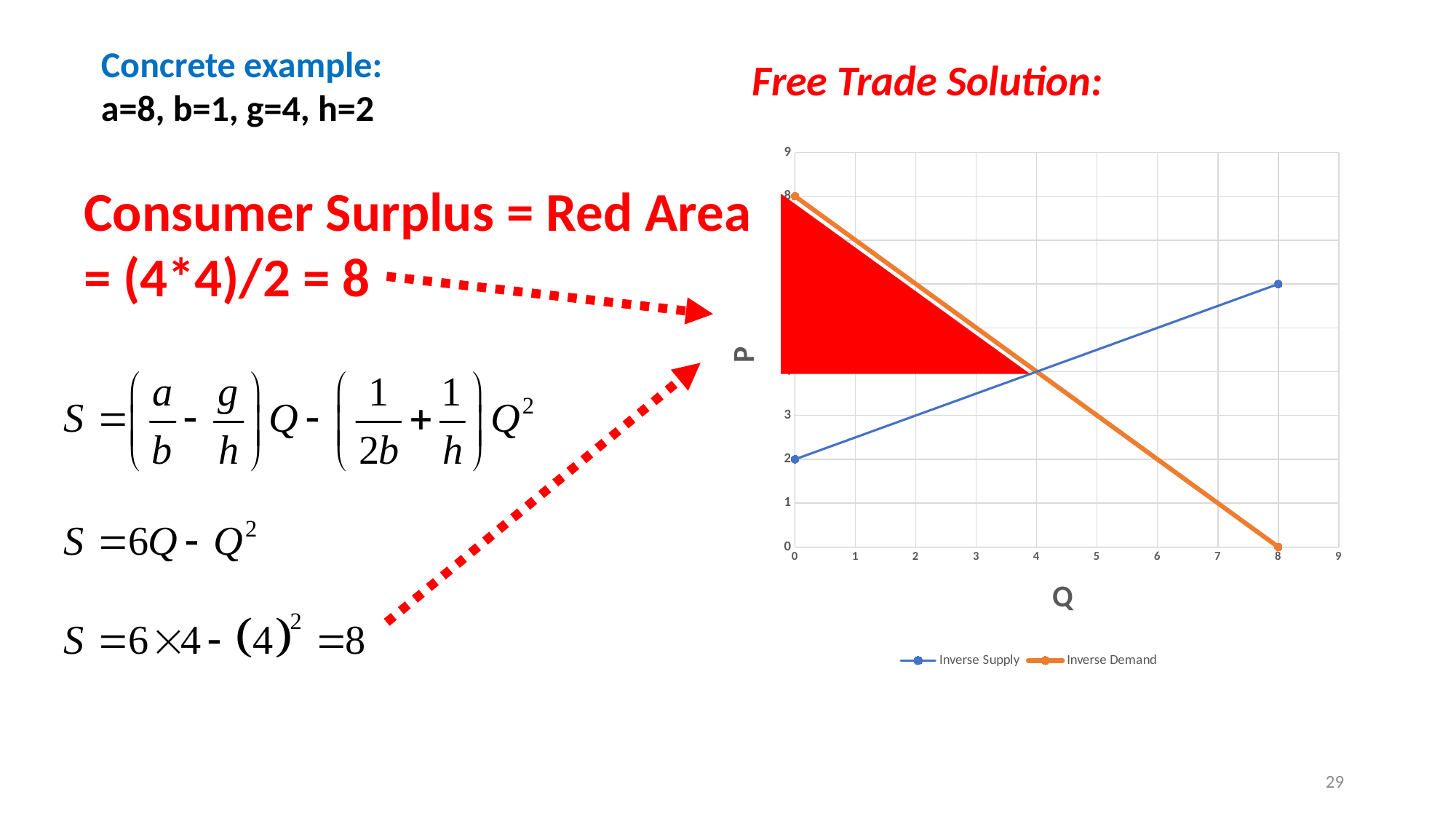
At Q = 0, which series has the higher value, Inverse Supply or Inverse Demand? Inverse Demand How many series does the chart's legend list? 2 What kind of chart is shown on the slide? line chart Does the Inverse Demand line rise or fall as Q increases? fall What is the value of Inverse Supply at Q = 0? 2 What is the value of Inverse Demand at Q = 0? 8 Does the Inverse Supply line rise or fall as Q increases? rise At Q = 8, which series has the higher value, Inverse Supply or Inverse Demand? Inverse Supply What is the difference between Inverse Demand and Inverse Supply at Q = 0? 6 Is the value of Inverse Supply at Q = 8 greater or less than 3? greater What are the two series named in the chart's legend? Inverse Supply and Inverse Demand What is the value of Inverse Demand at Q = 8? 0